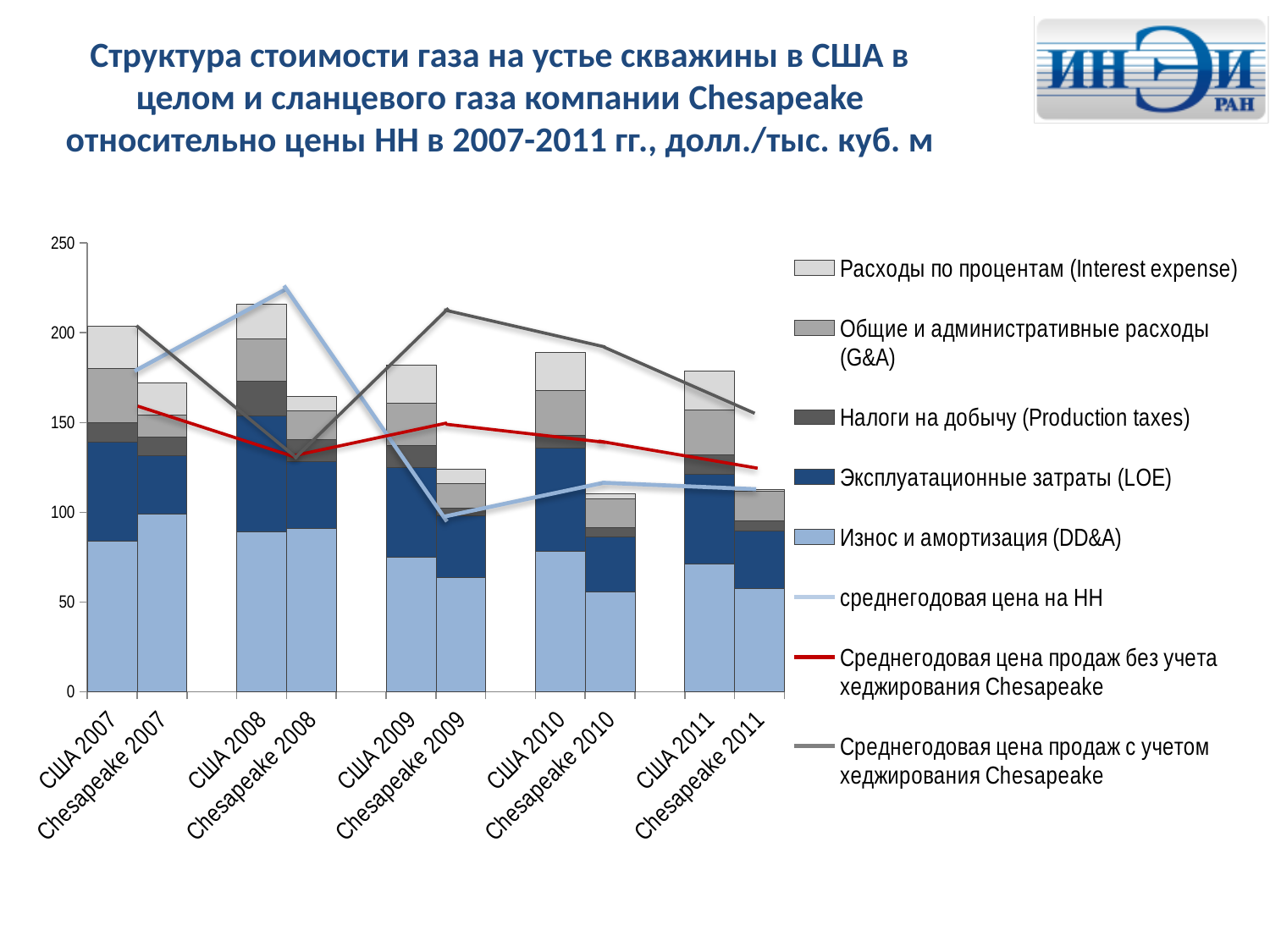
Is the total stacked bar for США 2010 greater or less than 200? less Does the 'среднегодовая цена на HH' line rise or fall from 2008 to 2009? fall Is the value of the 'среднегодовая цена на HH' line in 2008 greater or less than 200? greater Is the total stacked bar for Chesapeake 2011 greater or less than 150? less Which stacked bar is taller, США 2009 or Chesapeake 2009? США 2009 What colour represents 'Износ и амортизация (DD&A)' in the legend? light blue How many series does the legend list? 8 How many categories are shown on the x axis? 10 Which category has the tallest stacked bar? США 2008 What kind of chart is shown on the slide? bar chart